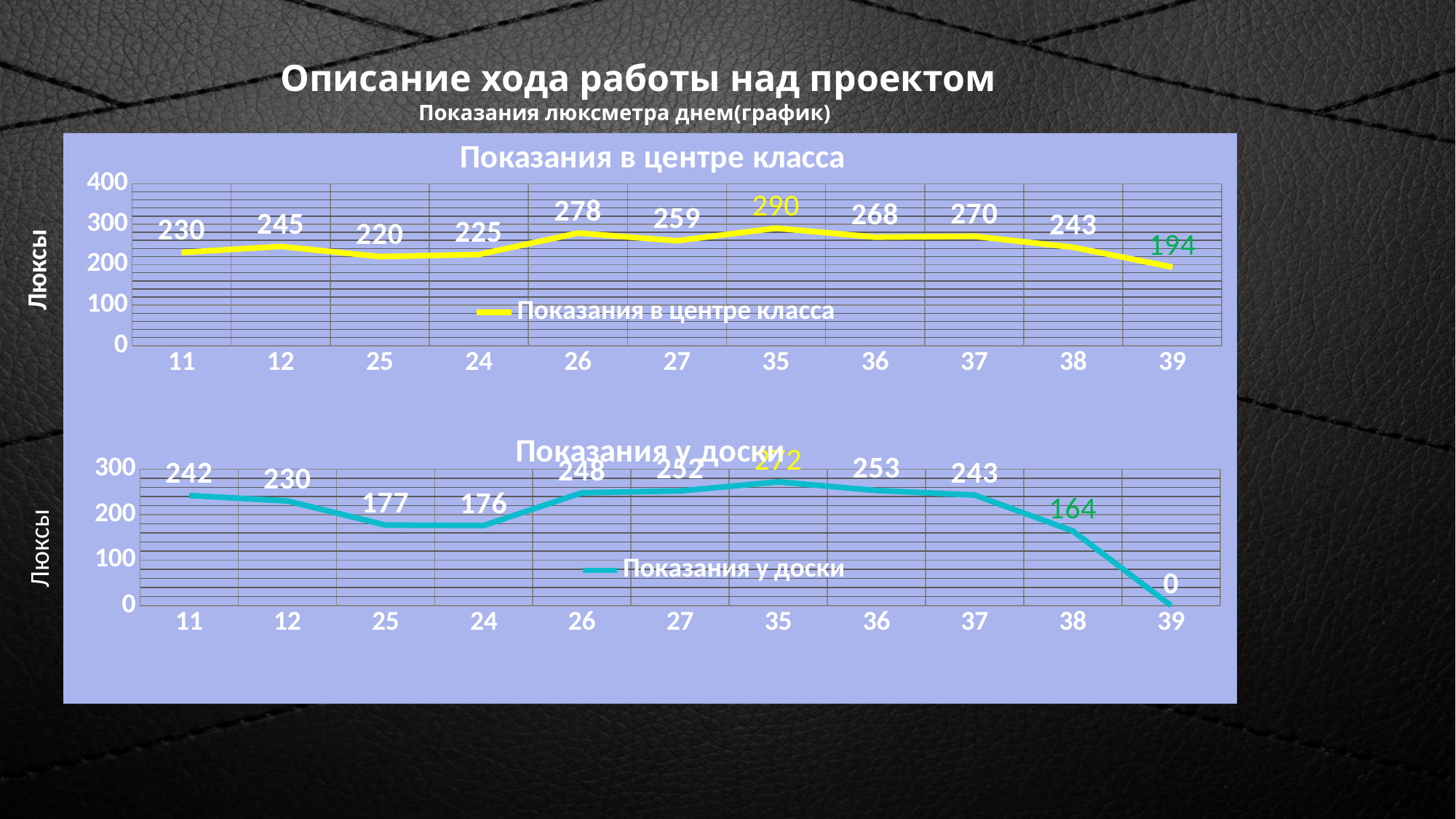
In the chart titled "Показания у доски", which is larger: the value at category 11 or at category 12? 11 In the chart titled "Показания в центре класса", what is the difference between the values at categories 26 and 25? 58 In the chart titled "Показания в центре класса", what is the value at category 35? 290 In the chart titled "Показания у доски", which category has the highest value? 35 How many data points are plotted in the chart titled "Показания у доски"? 11 What type of chart is the chart titled "Показания в центре класса"? line chart In the chart titled "Показания в центре класса", which category has the highest value? 35 In the chart titled "Показания у доски", what is the value at category 39? 0 What is the y-axis label of the chart titled "Показания у доски"? Люксы In the chart titled "Показания в центре класса", which category has the lowest value? 39 In the chart titled "Показания в центре класса", what is the value at category 39? 194 In the chart titled "Показания у доски", what is the value at category 38? 164